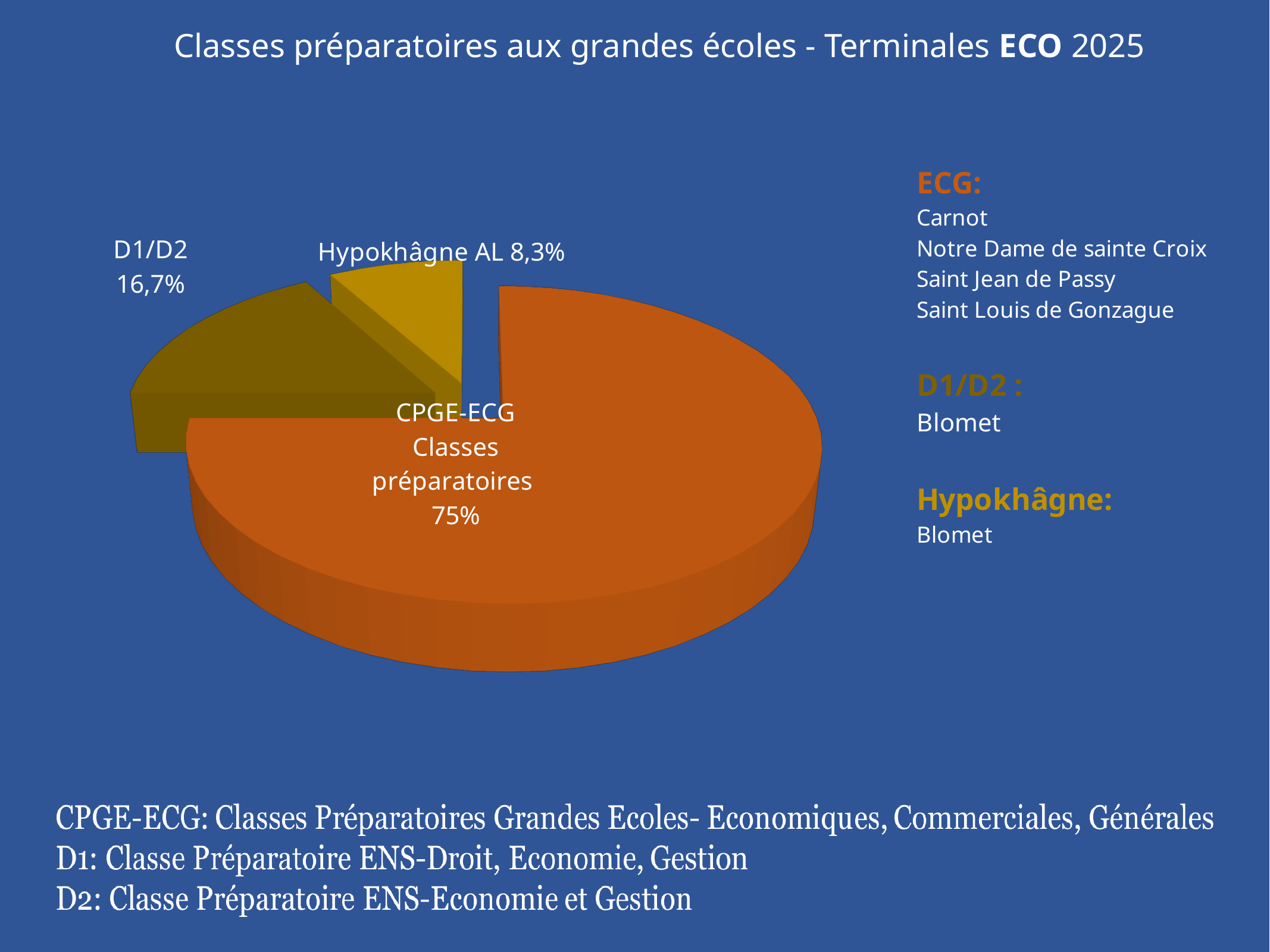
Which slice of the pie is the largest? CPGE-ECG Classes préparatoires How many slices does the pie chart have? 3 What share of the pie does Hypokhâgne AL have? 8,3% What share of the pie does D1/D2 have? 16,7% What is the difference in percentage points between the CPGE-ECG slice and the D1/D2 slice? 58,3 What is the title of the slide containing the pie chart? Classes préparatoires aux grandes écoles - Terminales ECO 2025 What is the difference in percentage points between the D1/D2 slice and the Hypokhâgne AL slice? 8,4 Which is larger, the D1/D2 slice or the Hypokhâgne AL slice? D1/D2 What kind of chart is shown on the slide? pie chart What colour is the CPGE-ECG Classes préparatoires slice? orange Which slice of the pie is the smallest? Hypokhâgne AL What share of the pie does CPGE-ECG Classes préparatoires have? 75%